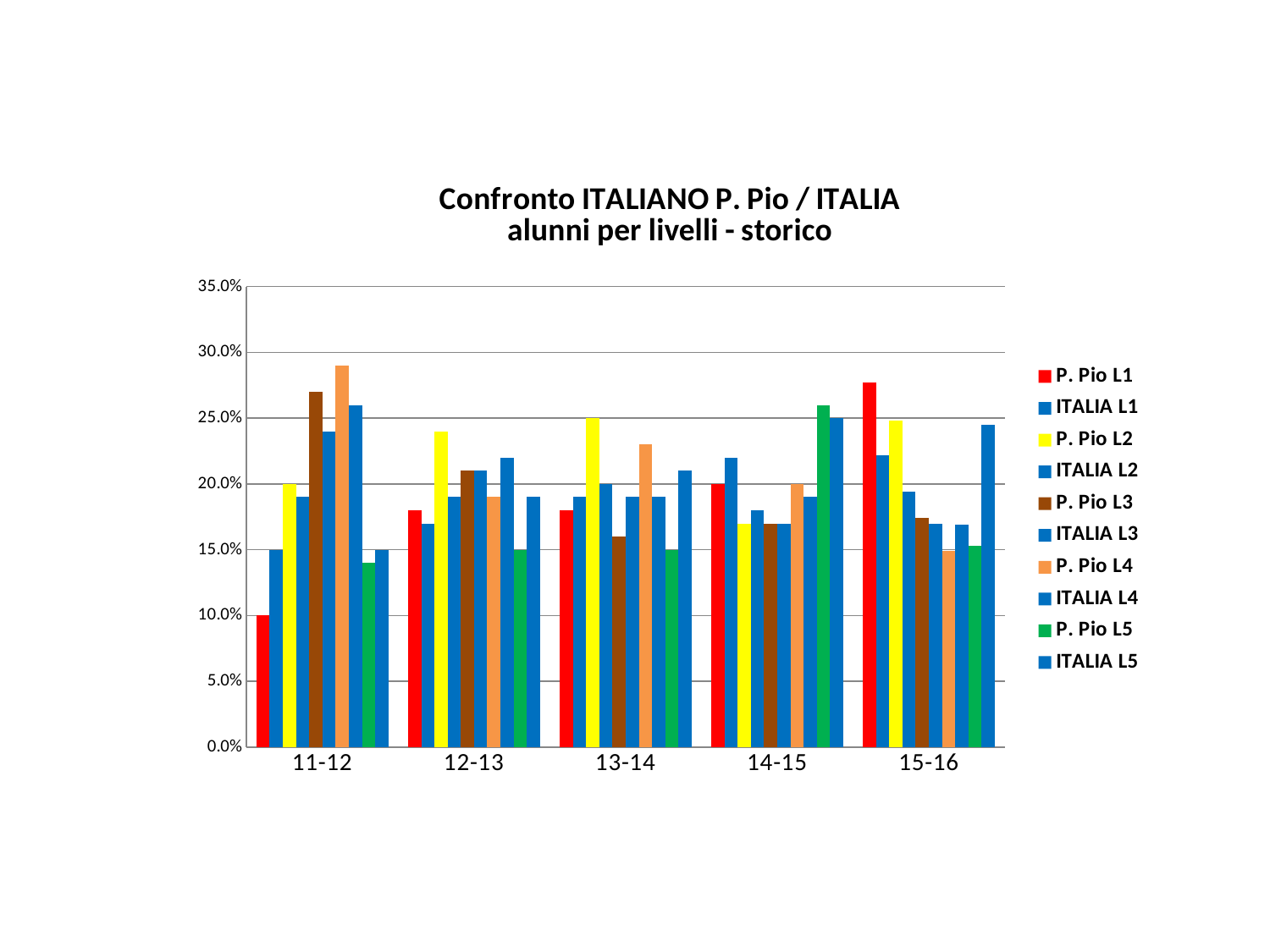
Does P. Pio L1 rise or fall overall from 11-12 to 15-16? rise Is the value for P. Pio L5 in 11-12 greater or less than 15%? less What is the value of P. Pio L1 for 14-15? 20.0% How many series does the legend list? 10 What kind of chart is shown on the slide? bar chart How many school-year categories are shown on the x axis? 5 In which year is P. Pio L1 highest? 15-16 What is the value of P. Pio L1 for 11-12? 10.0% In which year is P. Pio L1 lowest? 11-12 Is the value for P. Pio L4 in 11-12 greater or less than 25%? greater In 13-14, which is larger: P. Pio L2 or ITALIA L2? P. Pio L2 What is the value of P. Pio L2 for 13-14? 25.0%